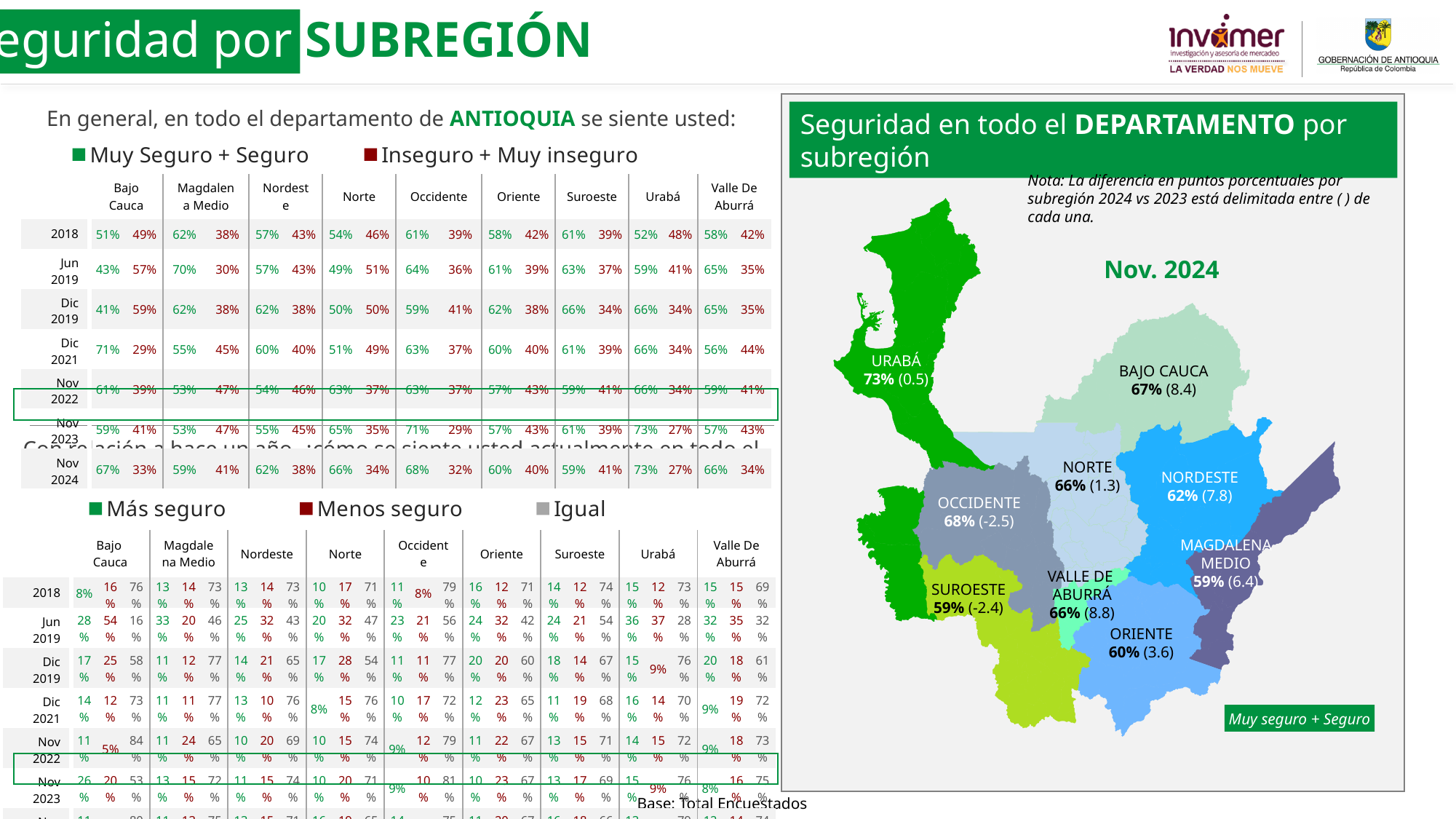
In the top table, what is the Muy Seguro + Seguro percentage for Bajo Cauca in Dic 2021? 71% On the map chart, which has a higher Muy seguro + Seguro percentage, Occidente or Norte? Occidente How many subregions are labelled with values on the map chart? 9 In the top table, what is the Inseguro + Muy inseguro percentage for Urabá in Nov 2024? 27% On the map chart, which subregion shows the largest increase in percentage points versus 2023? Valle de Aburrá Which period does the map chart show data for? Nov. 2024 On the map chart, what is the difference between the Muy seguro + Seguro percentage of Urabá and that of Suroeste? 14 percentage points On the map chart, what is the difference in percentage points vs 2023 shown in parentheses for Valle de Aburrá? 8.8 On the map chart 'Seguridad en todo el DEPARTAMENTO por subregión', what is the Muy seguro + Seguro percentage for Urabá? 73% On the map chart, which subregion has the highest Muy seguro + Seguro percentage in Nov. 2024? Urabá In the top table, what is the Muy Seguro + Seguro percentage for Bajo Cauca in 2018? 51% How many series does the legend of the top table list? 2